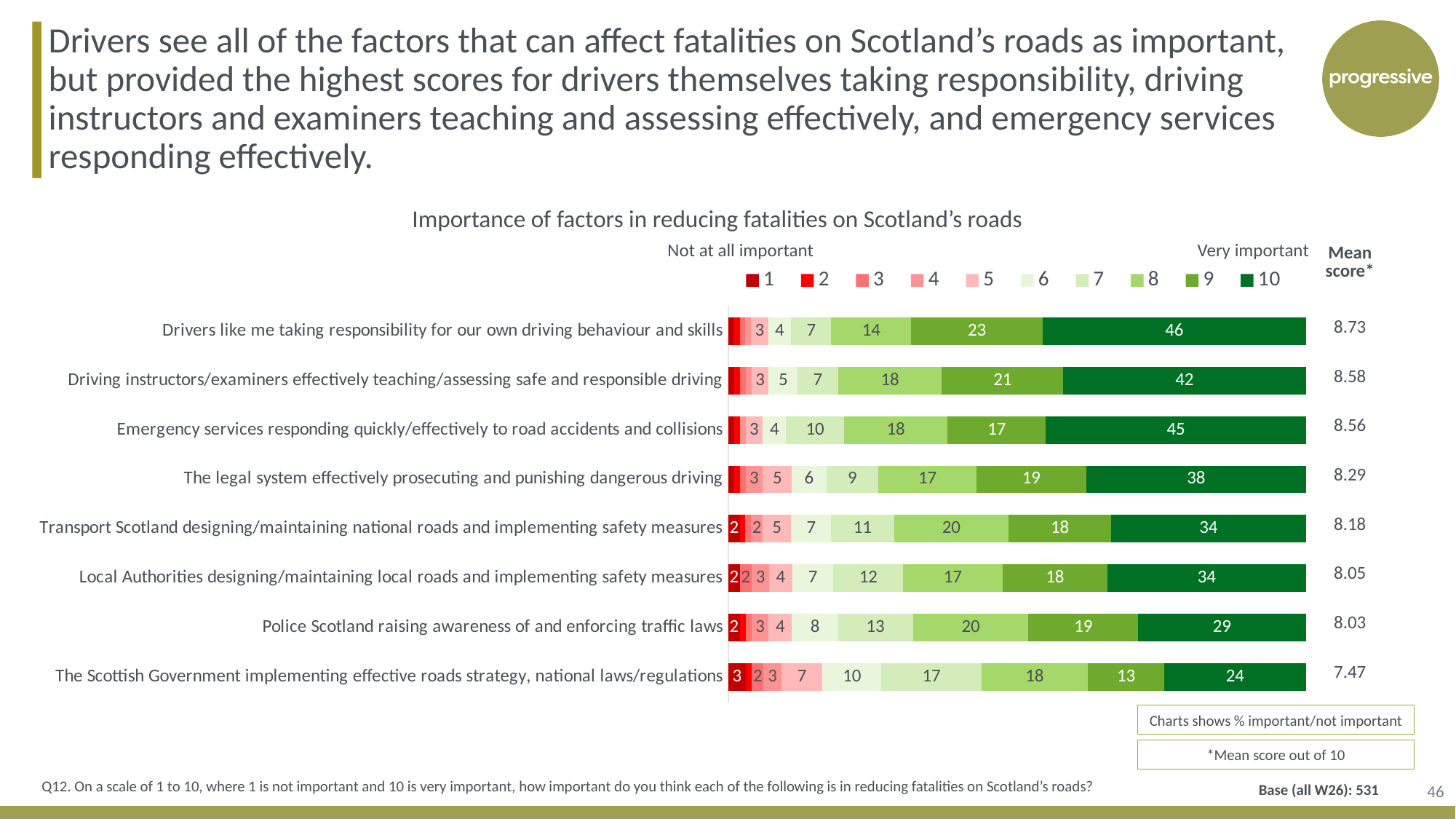
What kind of chart is shown on the slide? Stacked bar chart How many factors (categories) are plotted in the chart? 8 How many series does the chart legend list? 10 What is the difference between the percentage scoring 10 for 'Drivers like me taking responsibility...' and the percentage scoring 10 for 'Police Scotland raising awareness of and enforcing traffic laws'? 17 Which factor has the lowest mean score? The Scottish Government implementing effective roads strategy, national laws/regulations What percentage gave a score of 9 to 'Driving instructors/examiners effectively teaching/assessing safe and responsible driving'? 21 Which factor has the highest mean score? Drivers like me taking responsibility for our own driving behaviour and skills Which factor has a larger percentage scoring 10: 'Emergency services responding quickly/effectively to road accidents and collisions' or 'Driving instructors/examiners effectively teaching/assessing safe and responsible driving'? Emergency services responding quickly/effectively to road accidents and collisions What is the mean score for 'The Scottish Government implementing effective roads strategy, national laws/regulations'? 7.47 What percentage of drivers gave a score of 10 (very important) to 'Drivers like me taking responsibility for our own driving behaviour and skills'? 46 What is the title of the chart? Importance of factors in reducing fatalities on Scotland's roads What is the difference between the highest mean score (8.73) and the lowest mean score (7.47)? 1.26